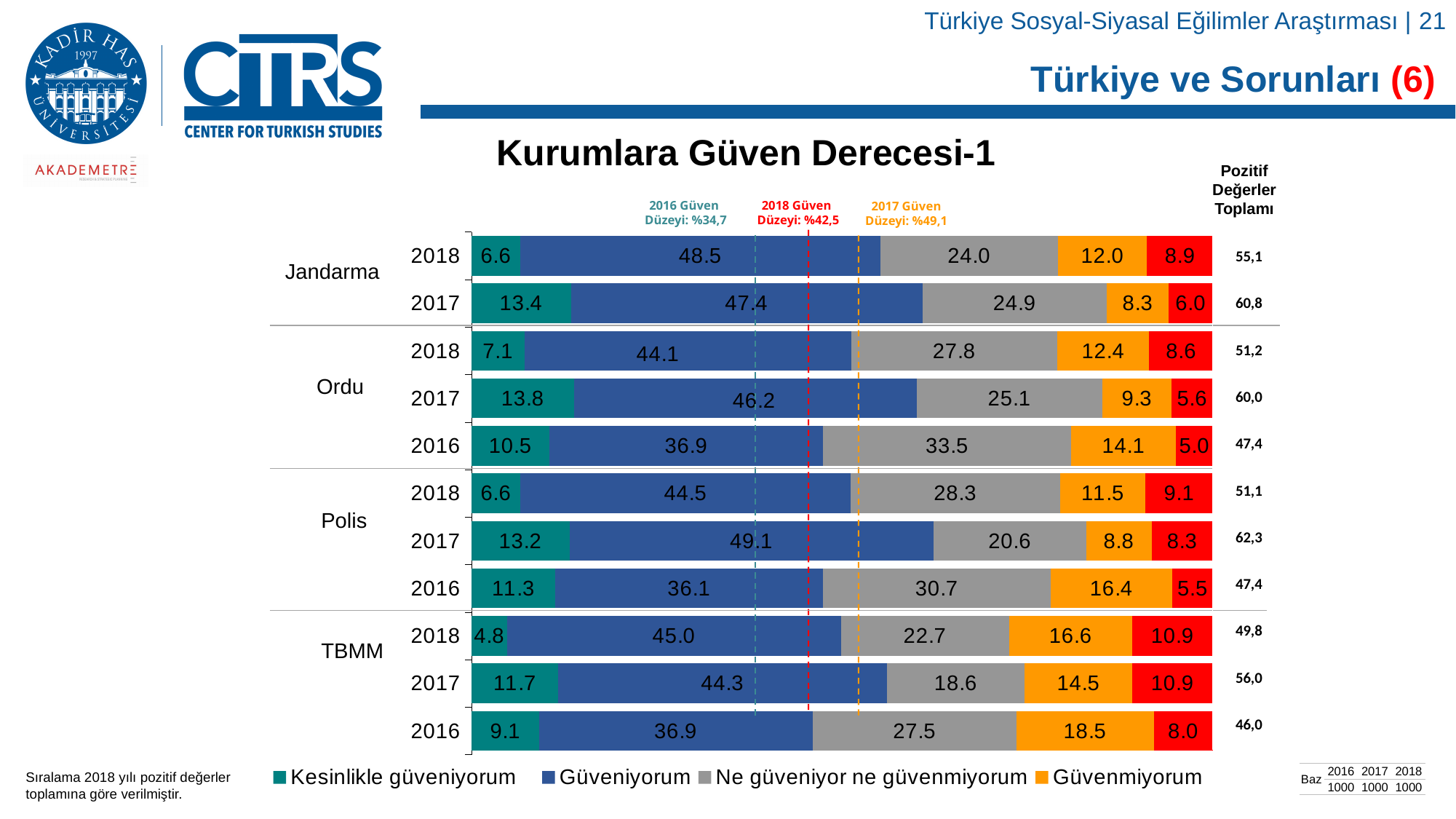
How many series does the legend list? 4 Which bar has the highest Pozitif Değerler Toplamı? Polis 2017 What is the difference between the Güveniyorum values for Polis in 2017 and Polis in 2016? 13.0 What is the value of the Ne güveniyor ne güvenmiyorum segment for Ordu in 2016? 33.5 What is the value of the Güveniyorum segment for Jandarma in 2018? 48.5 How many bars are plotted in the chart? 11 What is the 2018 Güven Düzeyi shown by the red dashed line? %42,5 What kind of chart is shown on the slide? Stacked bar chart What is the Pozitif Değerler Toplamı for Polis in 2017? 62,3 Which is larger, the Güvenmiyorum value for Ordu in 2018 or for Polis in 2018? Ordu 2018 What is the value of the Güvenmiyorum segment for TBMM in 2018? 16.6 Which bar has the lowest Pozitif Değerler Toplamı? TBMM 2016